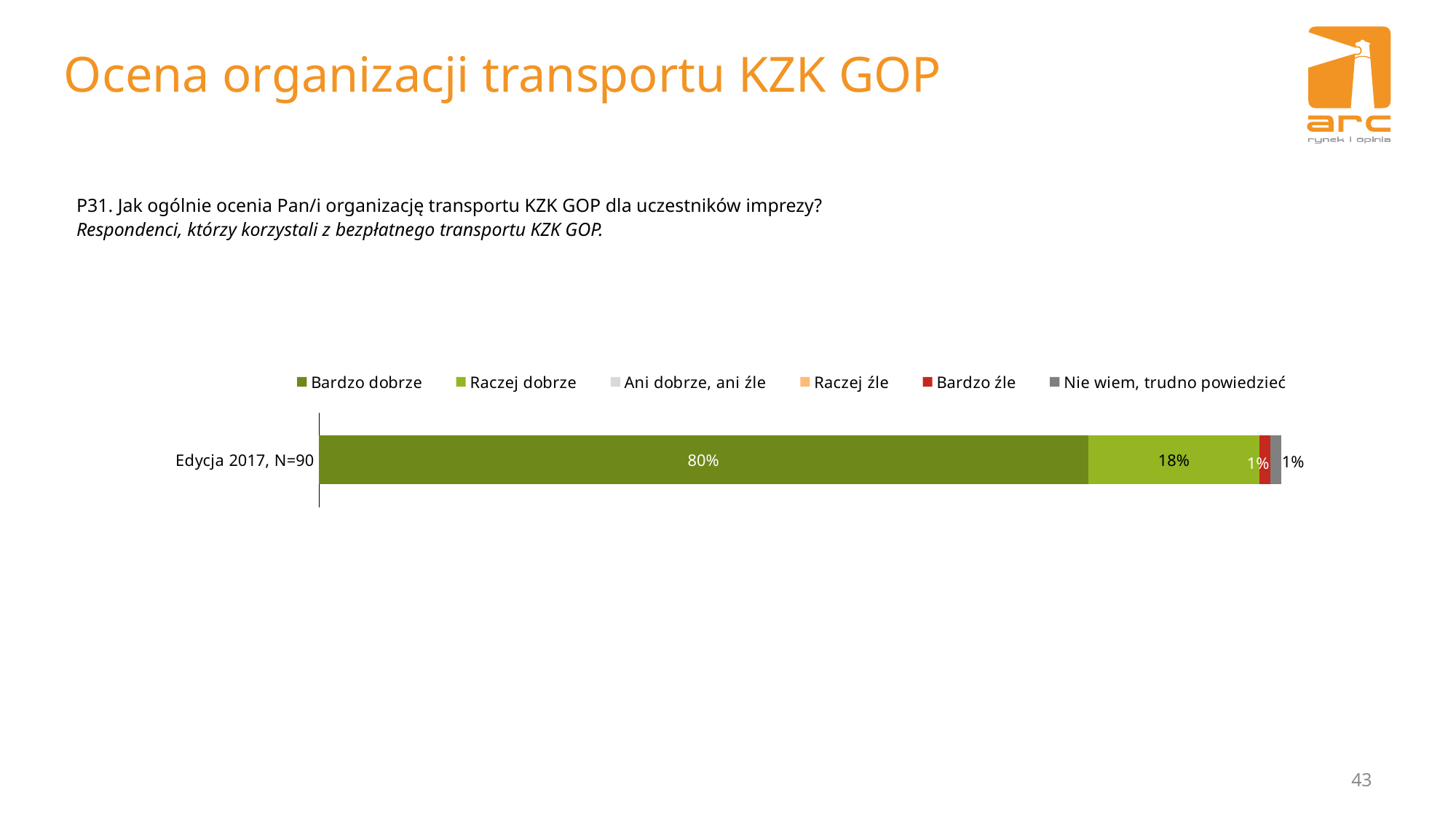
Which response category has the highest share in the chart? Bardzo dobrze Which is larger, the share for "Raczej dobrze" or the share for "Bardzo źle"? Raczej dobrze What is the combined share of "Bardzo dobrze" and "Raczej dobrze" responses? 98% What percentage of respondents answered "Nie wiem, trudno powiedzieć" in Edycja 2017? 1% What percentage of respondents answered "Bardzo źle" in Edycja 2017? 1% What percentage of respondents answered "Raczej dobrze" in Edycja 2017? 18% What percentage of respondents answered "Bardzo dobrze" in Edycja 2017? 80% How many bars (categories) are plotted in the chart? 1 How many series does the legend list? 6 What is the label of the single bar in the chart? Edycja 2017, N=90 What kind of chart is shown on the slide? Stacked horizontal bar chart What is the difference between the "Bardzo dobrze" and "Raczej dobrze" shares? 62 percentage points